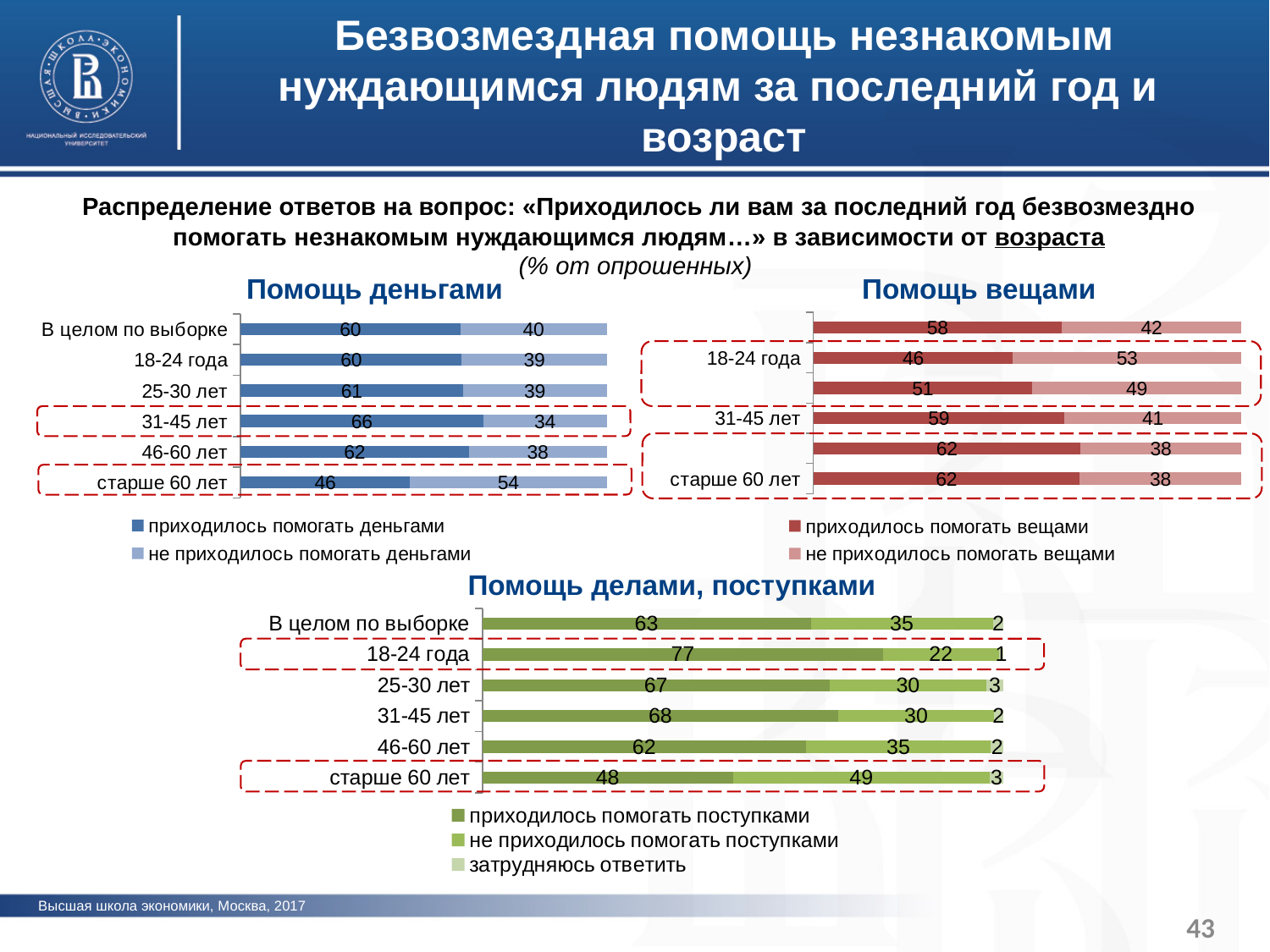
In the chart "Помощь делами, поступками", which category has the lowest value for "приходилось помогать поступками"? старше 60 лет How many series does the legend of the chart "Помощь делами, поступками" list? 3 In the chart "Помощь деньгами", what is the difference between the "приходилось помогать деньгами" values for "31-45 лет" and "старше 60 лет"? 20 In the chart "Помощь вещами", what is the value for "не приходилось помогать вещами" in the "старше 60 лет" category? 38 How many categories are shown in the chart "Помощь делами, поступками"? 6 In the chart "Помощь деньгами", what is the value for "не приходилось помогать деньгами" in the "старше 60 лет" category? 54 In the chart "Помощь делами, поступками", what is the value for "приходилось помогать поступками" in the "18-24 года" category? 77 In the chart "Помощь деньгами", which category has the lowest value for "приходилось помогать деньгами"? старше 60 лет In the chart "Помощь вещами", what is the value for "приходилось помогать вещами" in the "18-24 года" category? 46 In the chart "Помощь деньгами", what is the value for "приходилось помогать деньгами" in the "31-45 лет" category? 66 In the chart "Помощь деньгами", which age category has the highest value for "приходилось помогать деньгами"? 31-45 лет In the chart "Помощь вещами", which is larger: the "приходилось помогать вещами" value for "31-45 лет" or for "18-24 года"? 31-45 лет